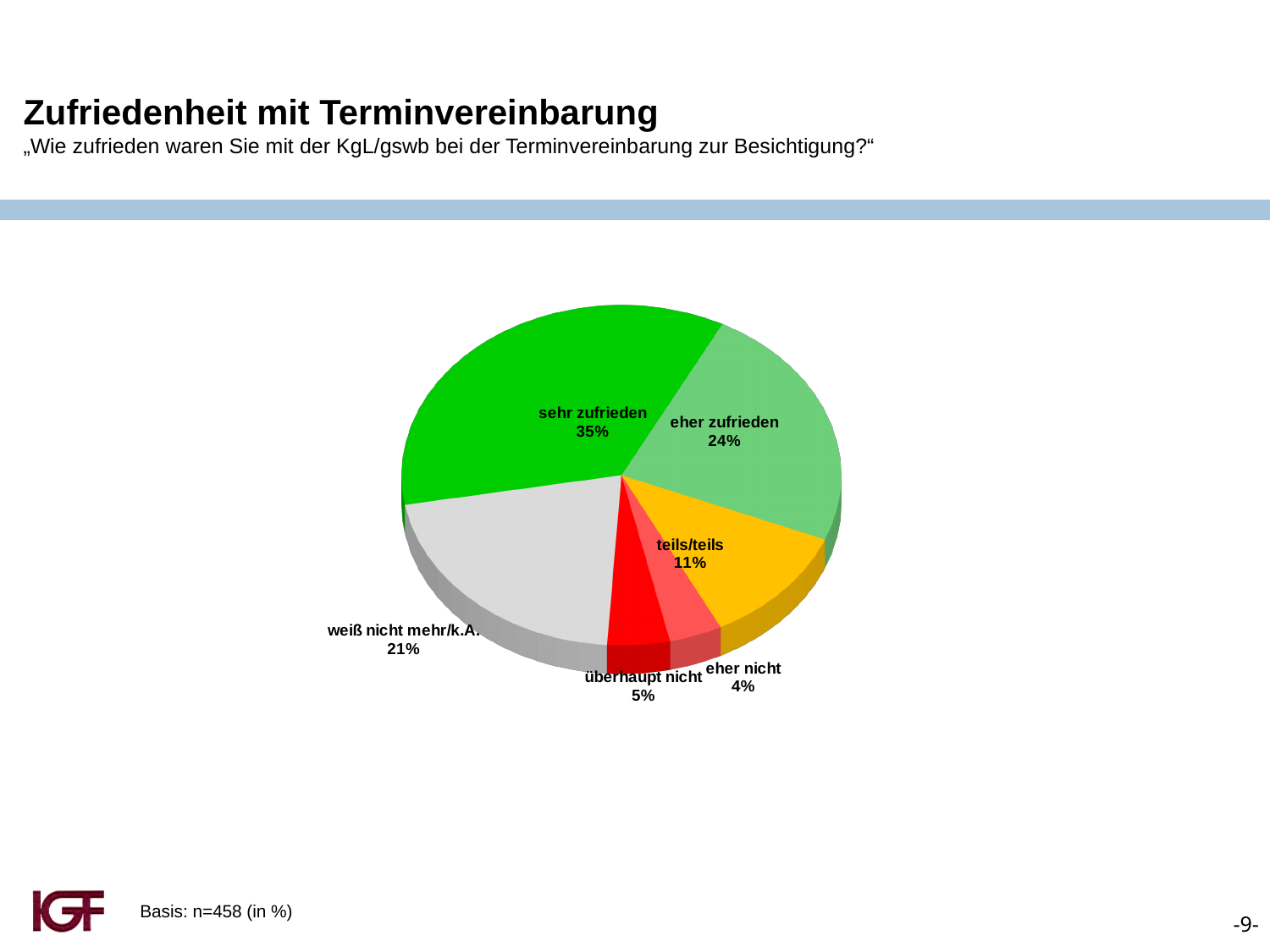
How many categories are shown in the pie chart? 6 What is the combined share of "sehr zufrieden" and "eher zufrieden"? 59% What percentage of respondents answered "sehr zufrieden"? 35% What is the difference in percentage points between "sehr zufrieden" and "eher zufrieden"? 11 Which category has the smallest share of the pie? eher nicht What percentage of respondents answered "eher zufrieden"? 24% What is the value for "weiß nicht mehr/k.A."? 21% What is the sample size (Basis) stated on the slide? n=458 Which category has the largest share of the pie? sehr zufrieden What is the value for "teils/teils"? 11% What kind of chart is shown on the slide? pie chart Which is larger, the share for "überhaupt nicht" or the share for "eher nicht"? überhaupt nicht